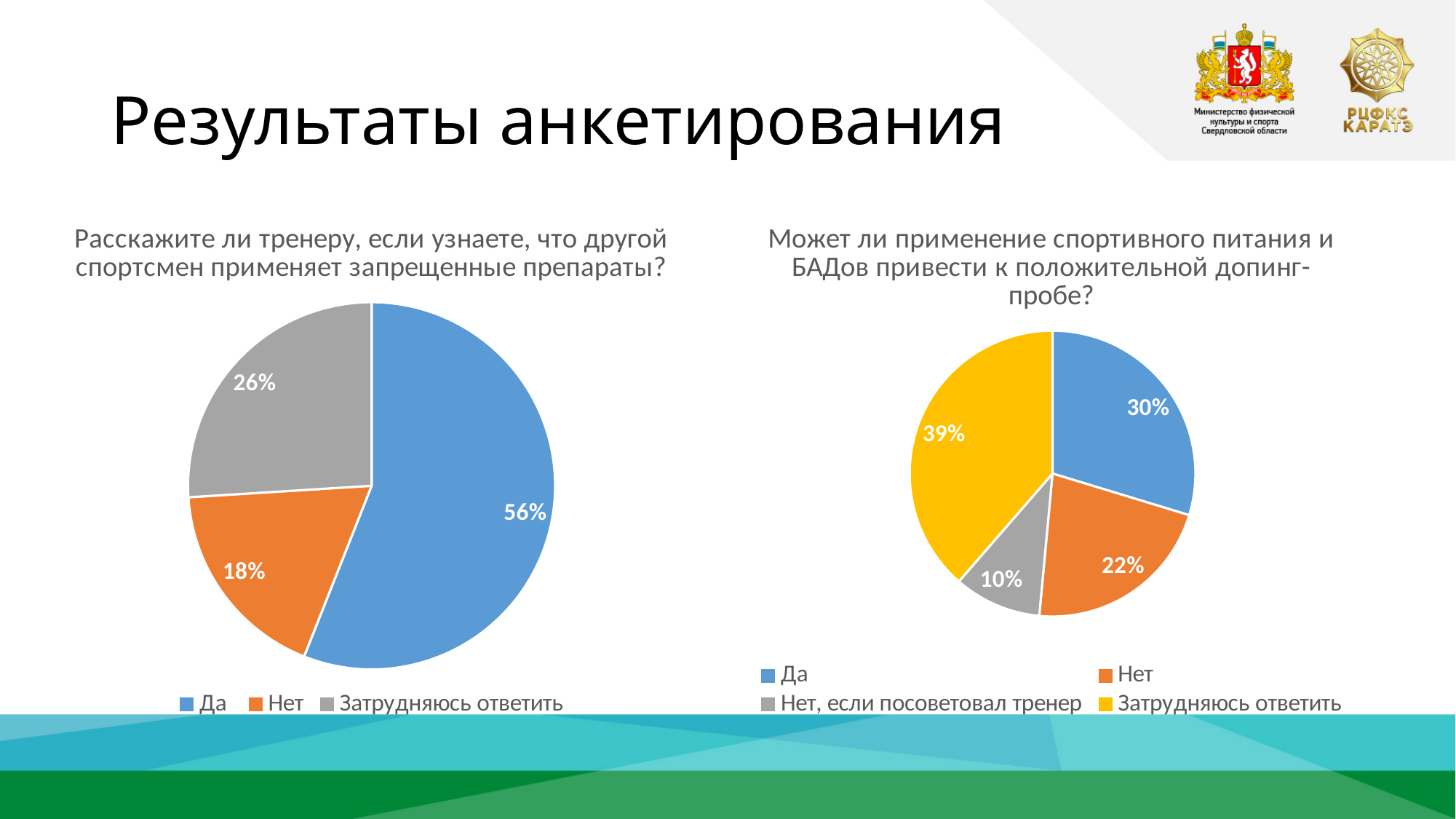
In the left pie chart ("Расскажите ли тренеру..."), what share of respondents answered "Нет"? 18% In the right pie chart ("Может ли применение спортивного питания..."), how many percentage points larger is "Да" than "Нет"? 8 In the right pie chart ("Может ли применение спортивного питания..."), which is larger: "Да" or "Нет"? Да In the left pie chart ("Расскажите ли тренеру..."), which answer has the smallest share? Нет In the left pie chart ("Расскажите ли тренеру..."), how many answer categories are shown? 3 In the left pie chart ("Расскажите ли тренеру..."), what share of respondents answered "Да"? 56% In the right pie chart ("Может ли применение спортивного питания..."), what share of respondents answered "Нет, если посоветовал тренер"? 10% In the left pie chart ("Расскажите ли тренеру..."), how many percentage points larger is "Да" than "Затрудняюсь ответить"? 30 In the right pie chart ("Может ли применение спортивного питания..."), which answer has the largest share? Затрудняюсь ответить What type of chart is used for both charts on the slide? Pie chart In the right pie chart ("Может ли применение спортивного питания..."), what share of respondents answered "Затрудняюсь ответить"? 39% In the right pie chart ("Может ли применение спортивного питания..."), how many entries does the legend list? 4